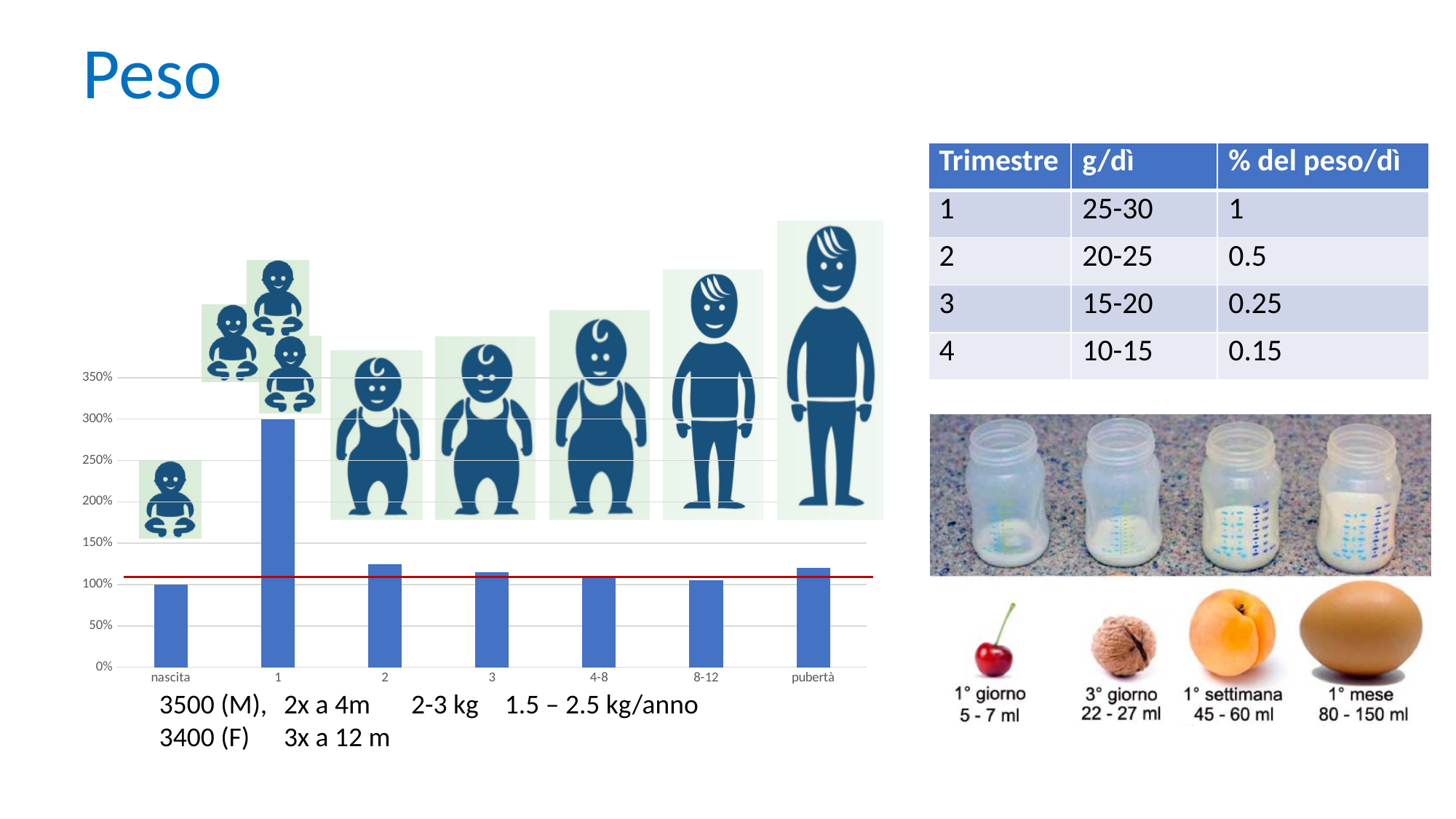
Is the value for 'pubertà' greater or less than 150%? less What is the highest value shown on the y axis of the chart? 350% Which category has the highest bar in the chart? 1 What kind of chart is shown on the left of the slide? bar chart What is the value of the bar for category '1'? 300% Is the value for category '2' greater or less than 100%? greater Is the value for category '2' greater or less than 150%? less How many categories are shown on the x axis of the bar chart? 7 What is the difference between the bar for '1' and the bar for 'nascita'? 200% What is the value of the bar for 'nascita'? 100% Which bar is taller, '2' or '8-12'? 2 Which bar is taller, '1' or '2'? 1